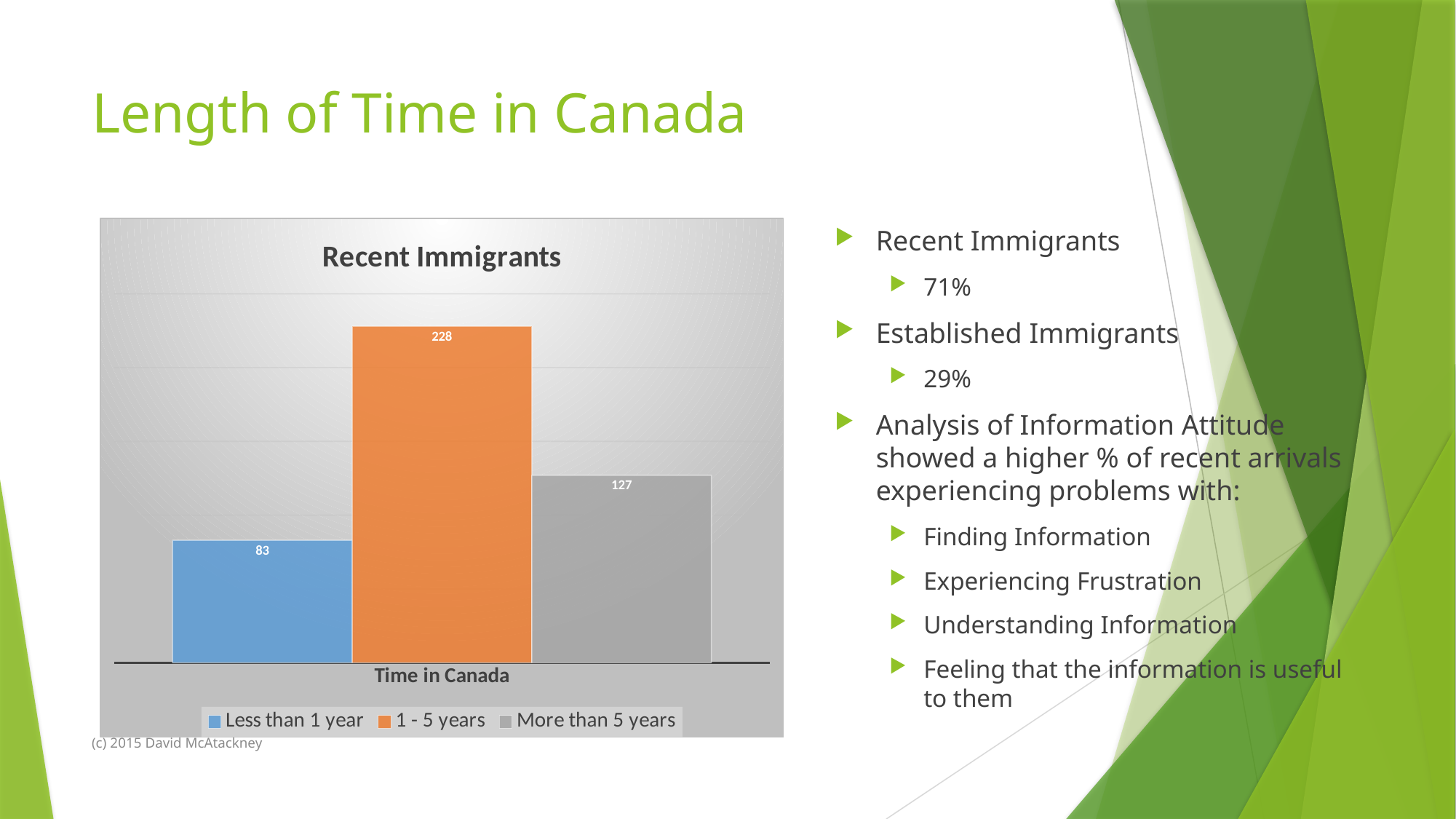
Which series has the highest value in the Recent Immigrants chart? 1 - 5 years What kind of chart is the Recent Immigrants chart? Bar chart How many series does the legend of the Recent Immigrants chart list? 3 What is the x-axis label of the Recent Immigrants chart? Time in Canada What is the difference between the '1 - 5 years' value and the 'More than 5 years' value in the Recent Immigrants chart? 101 What is the title of the chart on the slide? Recent Immigrants Which is larger in the Recent Immigrants chart: the value for 'More than 5 years' or the value for 'Less than 1 year'? More than 5 years What is the value for the 'Less than 1 year' series in the Recent Immigrants chart? 83 What is the value for the '1 - 5 years' series in the Recent Immigrants chart? 228 What is the difference between the 'More than 5 years' value and the 'Less than 1 year' value in the Recent Immigrants chart? 44 What is the value for the 'More than 5 years' series in the Recent Immigrants chart? 127 Which series has the lowest value in the Recent Immigrants chart? Less than 1 year